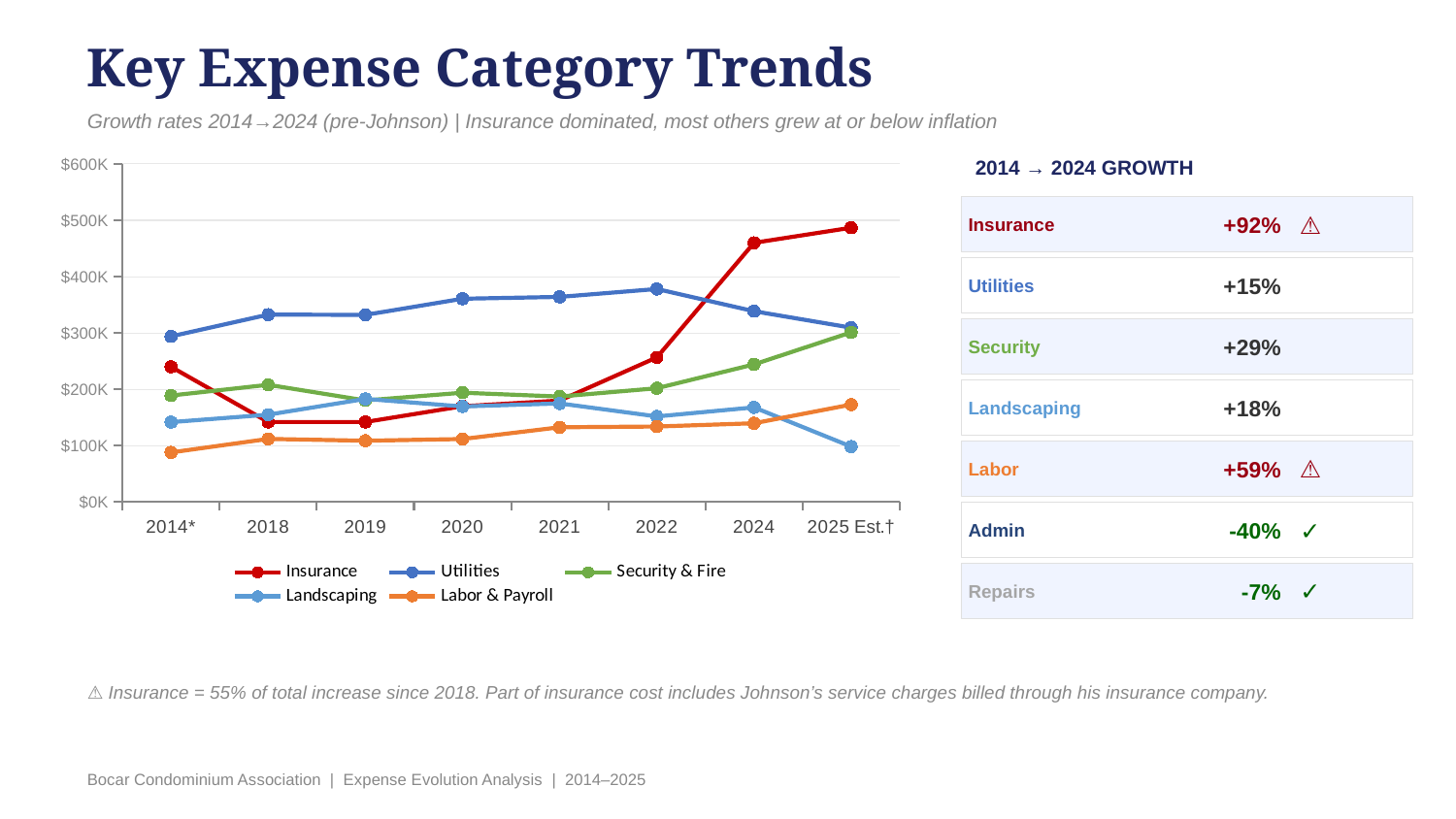
Does the Insurance line rise or fall from 2019 to 2025 Est.†? Rise How many points are shown along the x axis of the chart? 8 Is the value for Utilities in 2022 greater or less than $300K? greater Is the value for Insurance in 2019 greater or less than $200K? less What kind of chart is shown on the slide? Line chart What colour is the Insurance line in the chart? Red Which series has the highest value at 2014*? Utilities Is the value for Insurance in 2024 greater or less than $400K? greater How many series does the chart legend list? 5 Which series has the highest value at 2025 Est.†? Insurance Which series has the lowest value at 2014*? Labor & Payroll Which is larger in 2022, the value for Insurance or the value for Utilities? Utilities